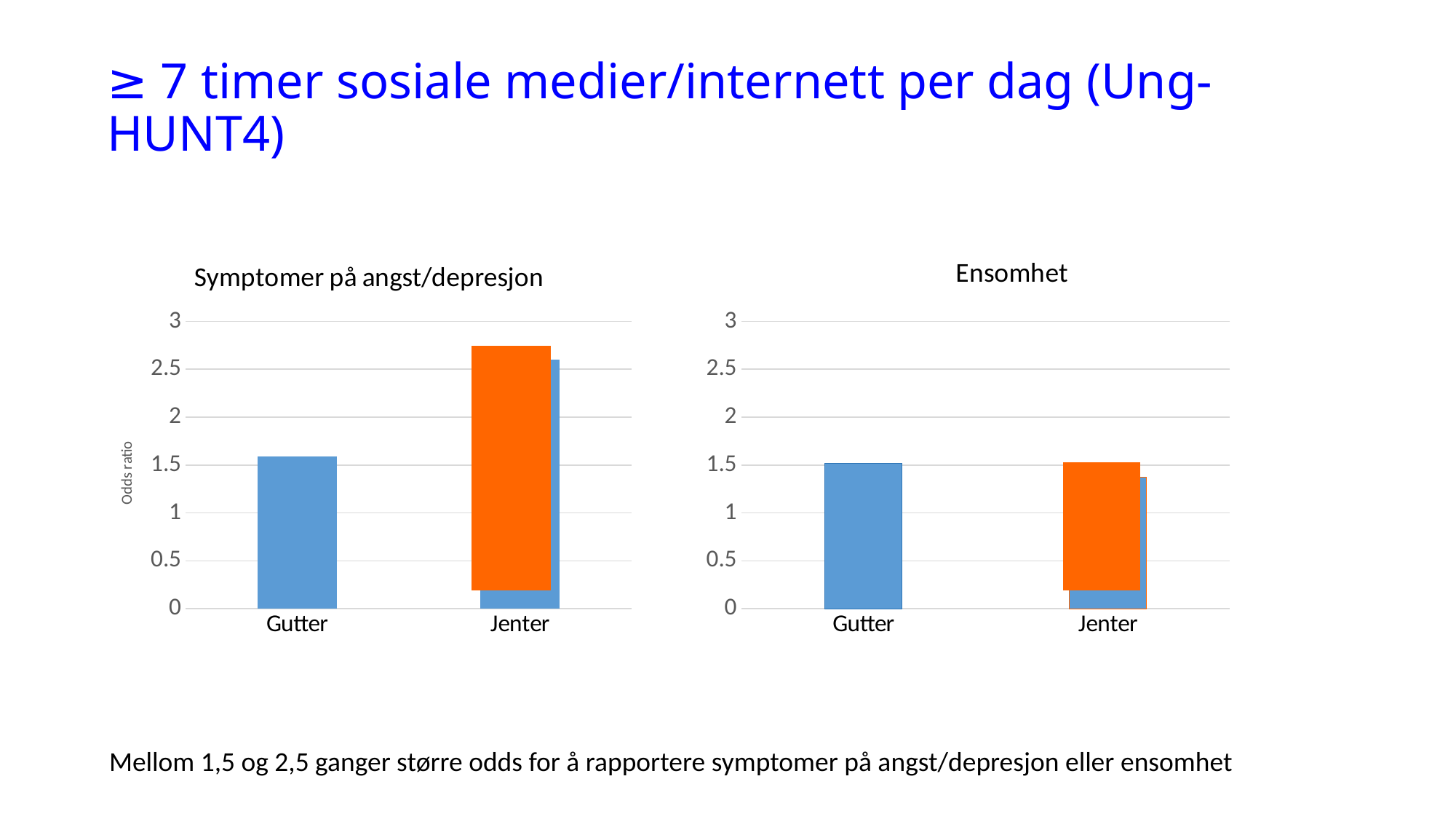
In the 'Symptomer på angst/depresjon' chart, which category has the highest value? Jenter In the 'Symptomer på angst/depresjon' chart, which is larger, the value for Gutter or the value for Jenter? Jenter In the 'Symptomer på angst/depresjon' chart, is the value for Jenter greater or less than 2? greater In the 'Symptomer på angst/depresjon' chart, how many categories are shown on the x axis? 2 In the 'Symptomer på angst/depresjon' chart, which category has the lowest value? Gutter What kind of chart is the 'Symptomer på angst/depresjon' chart? bar chart What is the y-axis label on the 'Symptomer på angst/depresjon' chart? Odds ratio In the 'Ensomhet' chart, is the value for Jenter greater or less than 1? greater In the 'Symptomer på angst/depresjon' chart, is the value for Gutter greater or less than 2? less In the 'Ensomhet' chart, how many categories are shown on the x axis? 2 In the 'Symptomer på angst/depresjon' chart, do the values rise or fall from Gutter to Jenter? rise